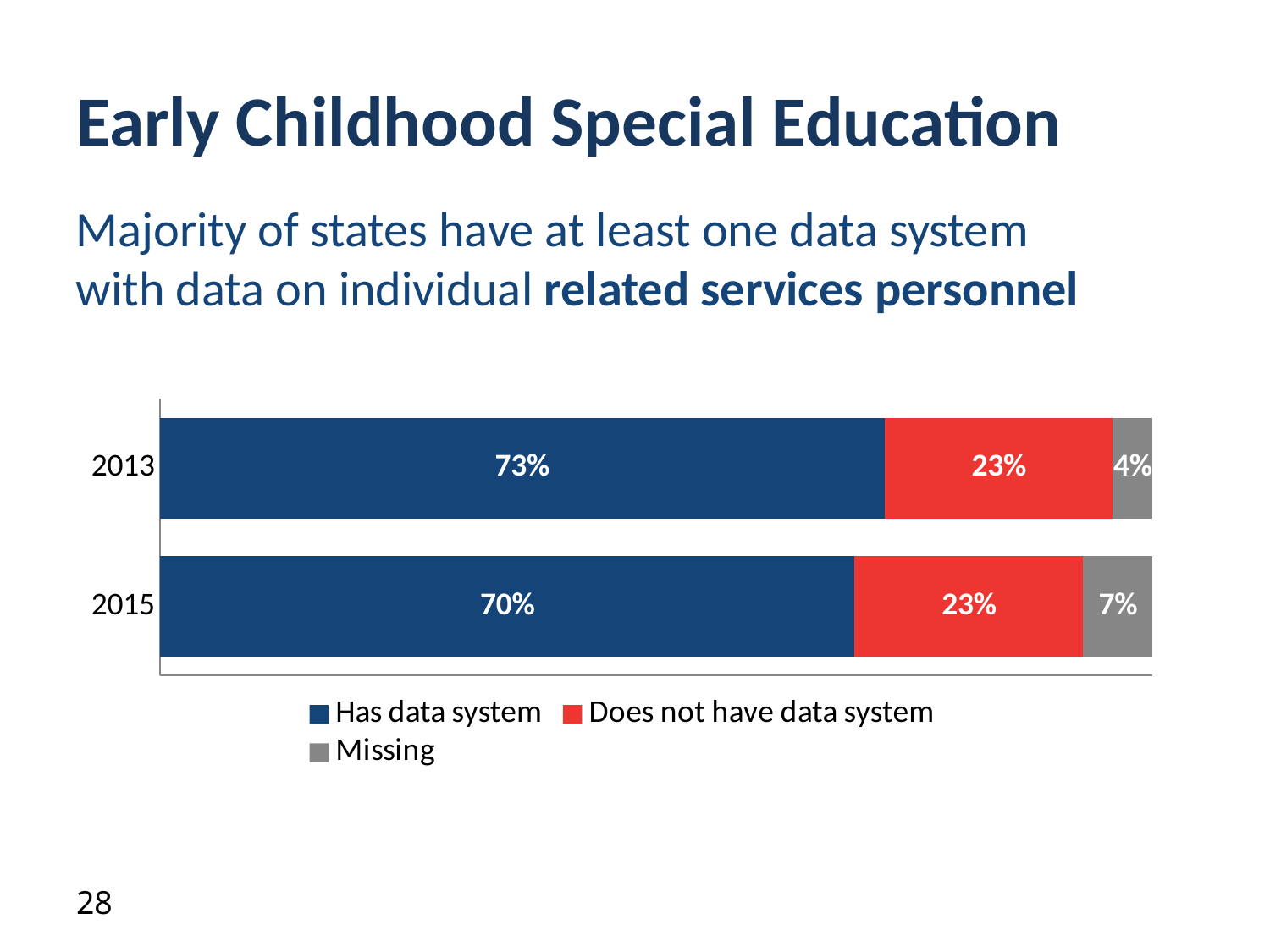
Which year has the higher 'Missing' value? 2015 How many years are shown on the chart? 2 What is the difference between the 'Has data system' values for 2013 and 2015? 3% What is the 'Does not have data system' value for 2013? 23% How many series does the legend list? 3 Which year has the higher 'Has data system' value? 2013 What kind of chart is shown on the slide? Stacked bar chart What percentage of states had a data system in 2015? 70% What percentage of states had a data system in 2013? 73% Which legend entry is shown in red? Does not have data system What is the 'Missing' value for 2015? 7% What is the difference between the 'Missing' values for 2015 and 2013? 3%